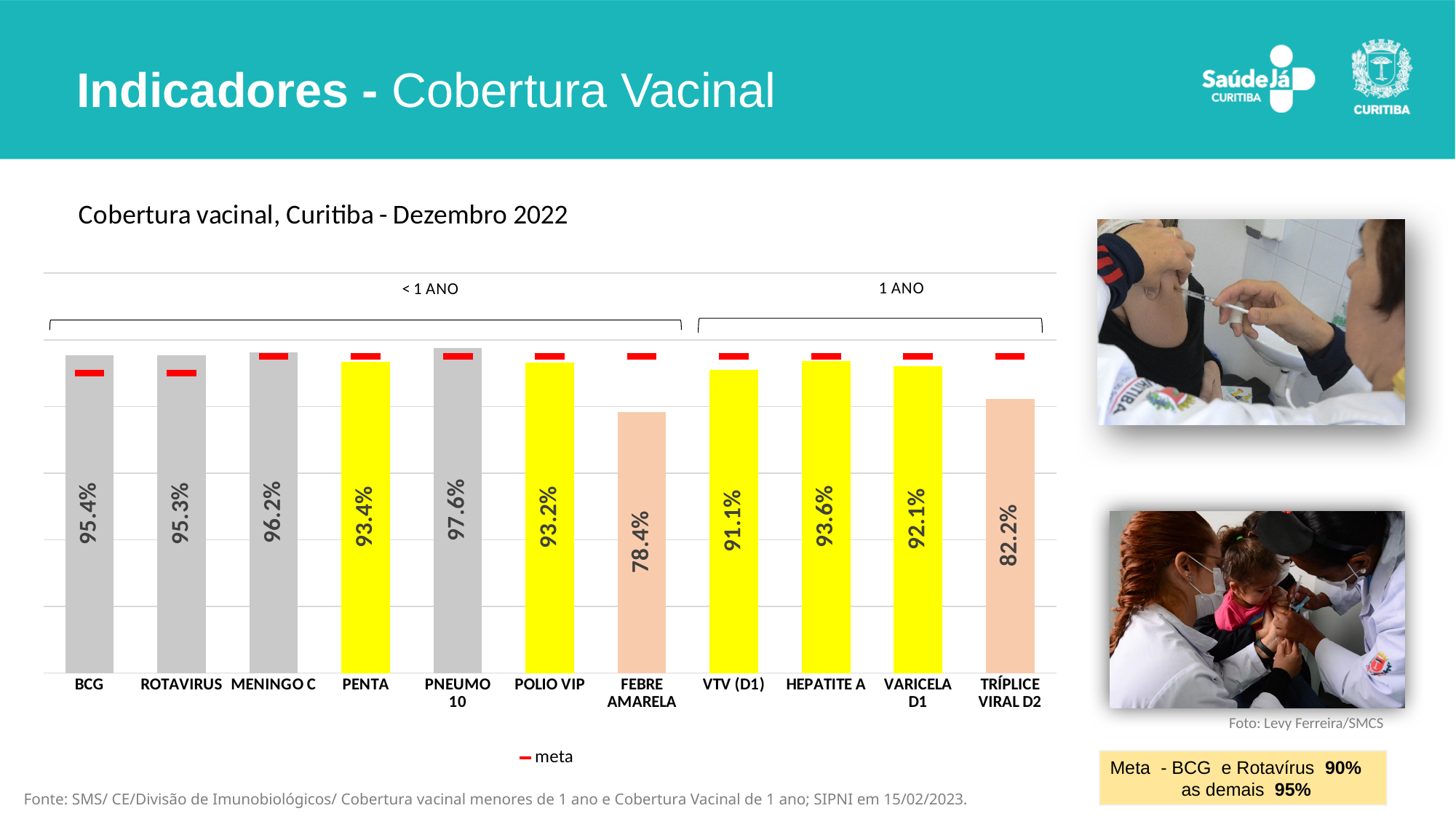
What is the vaccination coverage value shown for PNEUMO 10? 97.6% What is the difference between the coverage for BCG and ROTAVIRUS? 0.1% What is the difference between the coverage for PNEUMO 10 and FEBRE AMARELA? 19.2% What is the value shown for FEBRE AMARELA? 78.4% Which vaccine has the lowest coverage in the chart? FEBRE AMARELA Which has higher coverage, TRÍPLICE VIRAL D2 or POLIO VIP? POLIO VIP Which vaccine has the highest coverage in the chart? PNEUMO 10 What kind of chart is used to show the vaccination coverage? Bar chart What is the title of the chart? Cobertura vacinal, Curitiba - Dezembro 2022 What is the value shown for HEPATITE A? 93.6% How many vaccines (categories) are shown in the chart? 11 Which has higher coverage, VTV (D1) or VARICELA D1? VARICELA D1